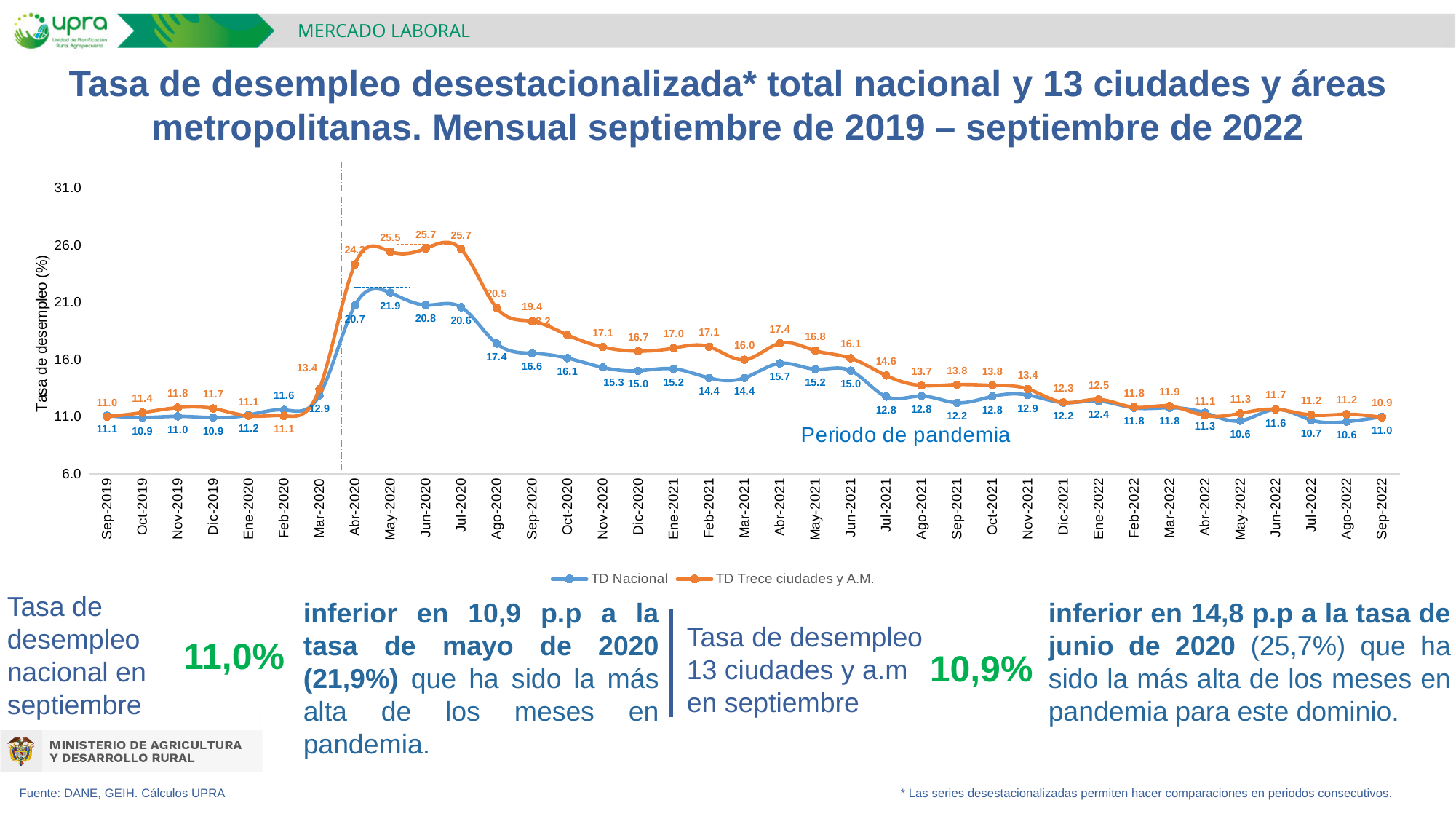
What is the value of TD Trece ciudades y A.M. in Abr-2021? 17.4 In which month does TD Trece ciudades y A.M. reach its lowest value? Sep-2022 Is the value of TD Nacional in Mar-2020 greater or less than 16.0? less What is the difference between TD Trece ciudades y A.M. and TD Nacional in Jul-2020? 5.1 What is the value of TD Trece ciudades y A.M. in Sep-2022? 10.9 Which series has the higher value in Ago-2020, TD Nacional or TD Trece ciudades y A.M.? TD Trece ciudades y A.M. What is the value of TD Nacional in Sep-2022? 11.0 In which month does TD Nacional reach its highest value? May-2020 What is the label of the series drawn in orange? TD Trece ciudades y A.M. What type of chart is shown on the slide? line chart How many series does the legend list? 2 What is the value of TD Nacional in May-2020? 21.9